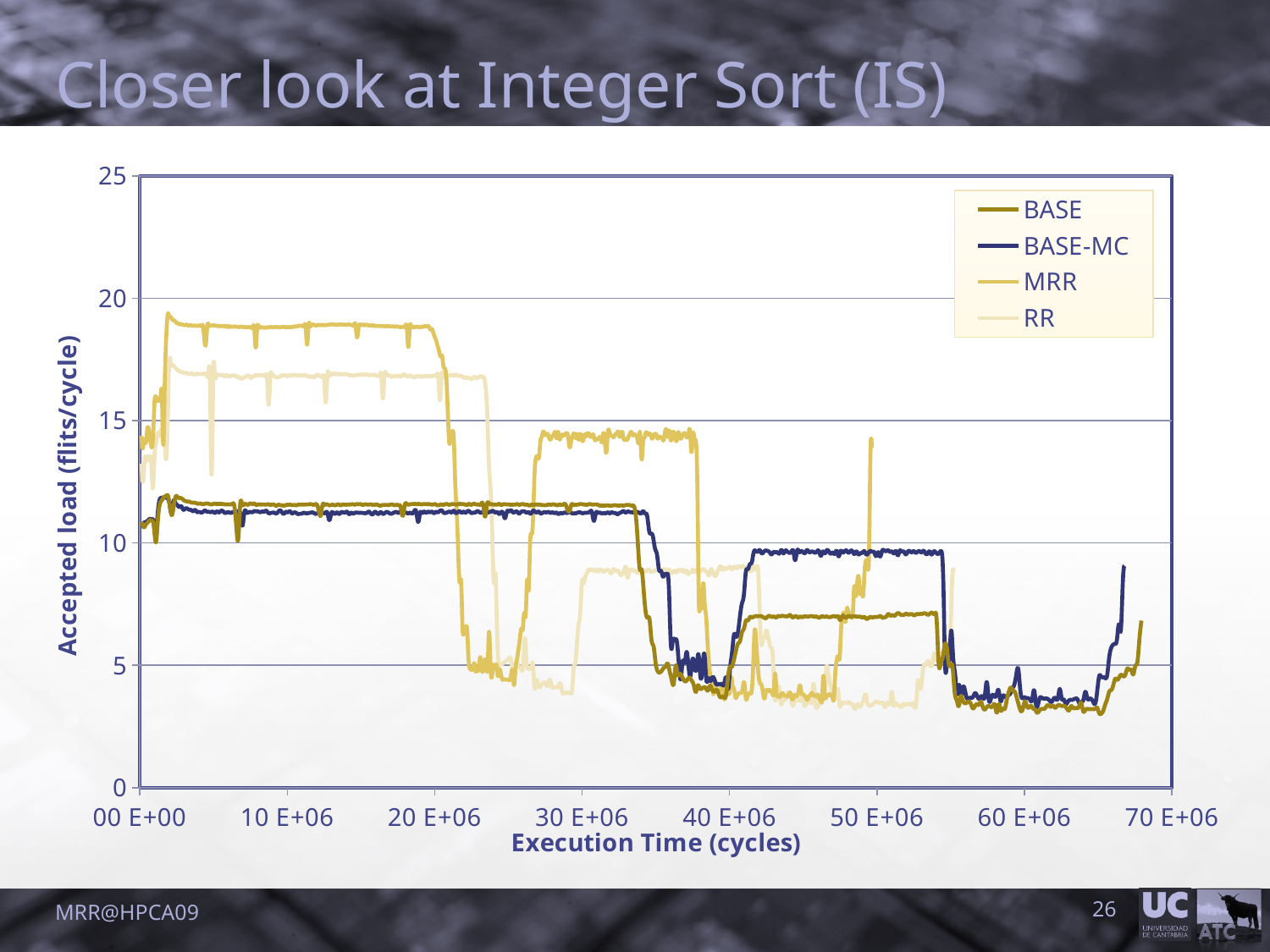
At 45 E+06 cycles, which is larger, BASE-MC or BASE? BASE-MC Does the MRR line generally rise or fall from the start to the end of the x axis? fall What is the title of the x axis? Execution Time (cycles) Which series reaches the highest accepted load anywhere on the chart? MRR What kind of chart is shown on the slide? line chart At 10 E+06 cycles, which is larger, MRR or BASE? MRR Is the value for BASE at 60 E+06 cycles greater or less than 5? less Is the value for MRR at 10 E+06 cycles greater or less than 15? greater Is the value for BASE at 10 E+06 cycles greater or less than 10? greater How many series does the legend list? 4 What is the title of the y axis? Accepted load (flits/cycle)